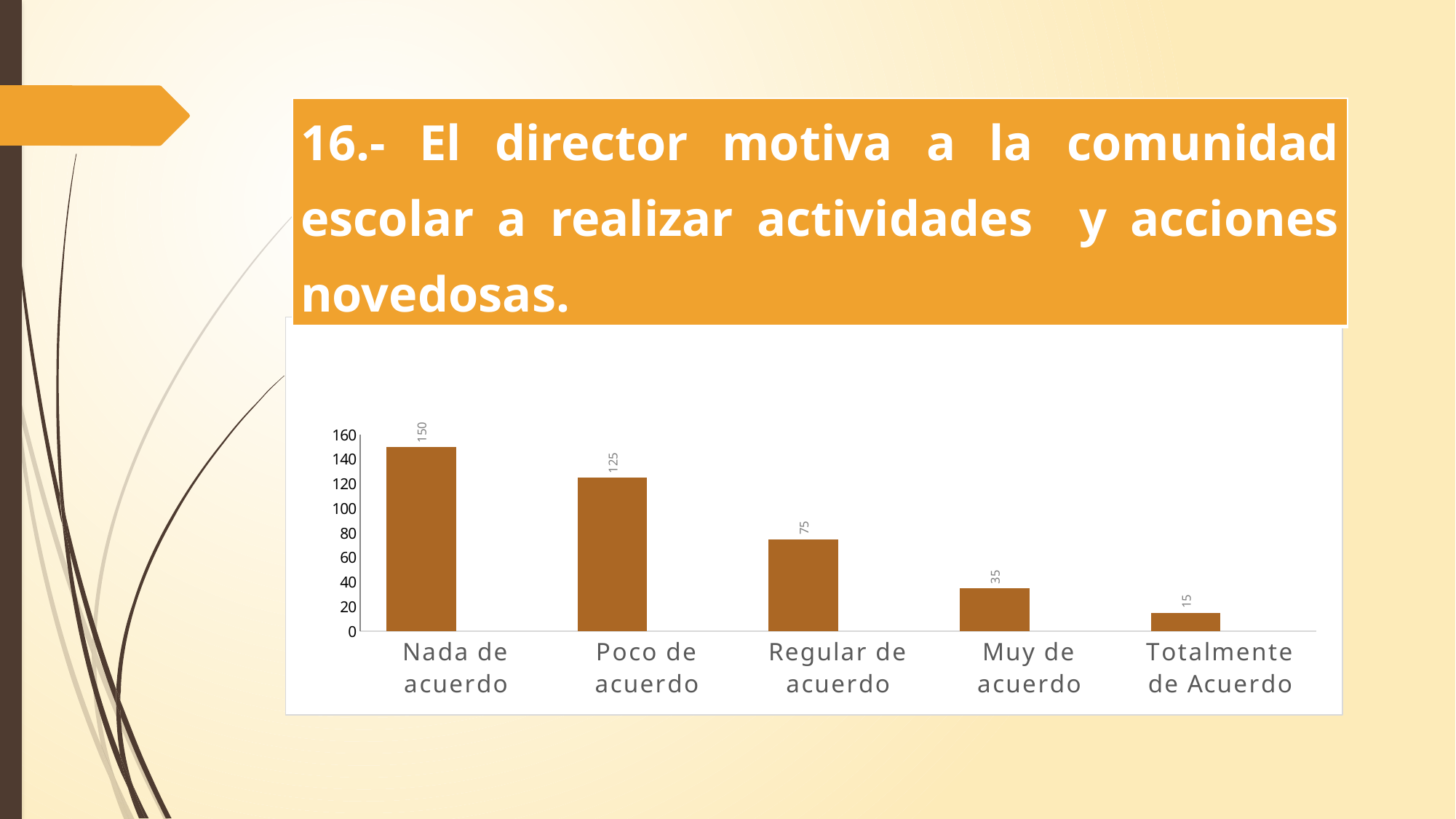
What is the difference between the values for "Regular de acuerdo" and "Muy de acuerdo"? 40 What is the value for "Totalmente de Acuerdo"? 15 How many categories are shown on the x axis? 5 What is the difference between the values for "Nada de acuerdo" and "Poco de acuerdo"? 25 What kind of chart is shown on the slide? Bar chart Do the values rise or fall from left to right along the x axis? Fall What is the value for "Regular de acuerdo"? 75 Which category has the highest value? Nada de acuerdo What is the value for "Nada de acuerdo"? 150 Is the value for "Poco de acuerdo" greater or less than 100? greater Which category has the lowest value? Totalmente de Acuerdo Which is larger, the value for "Poco de acuerdo" or the value for "Muy de acuerdo"? Poco de acuerdo